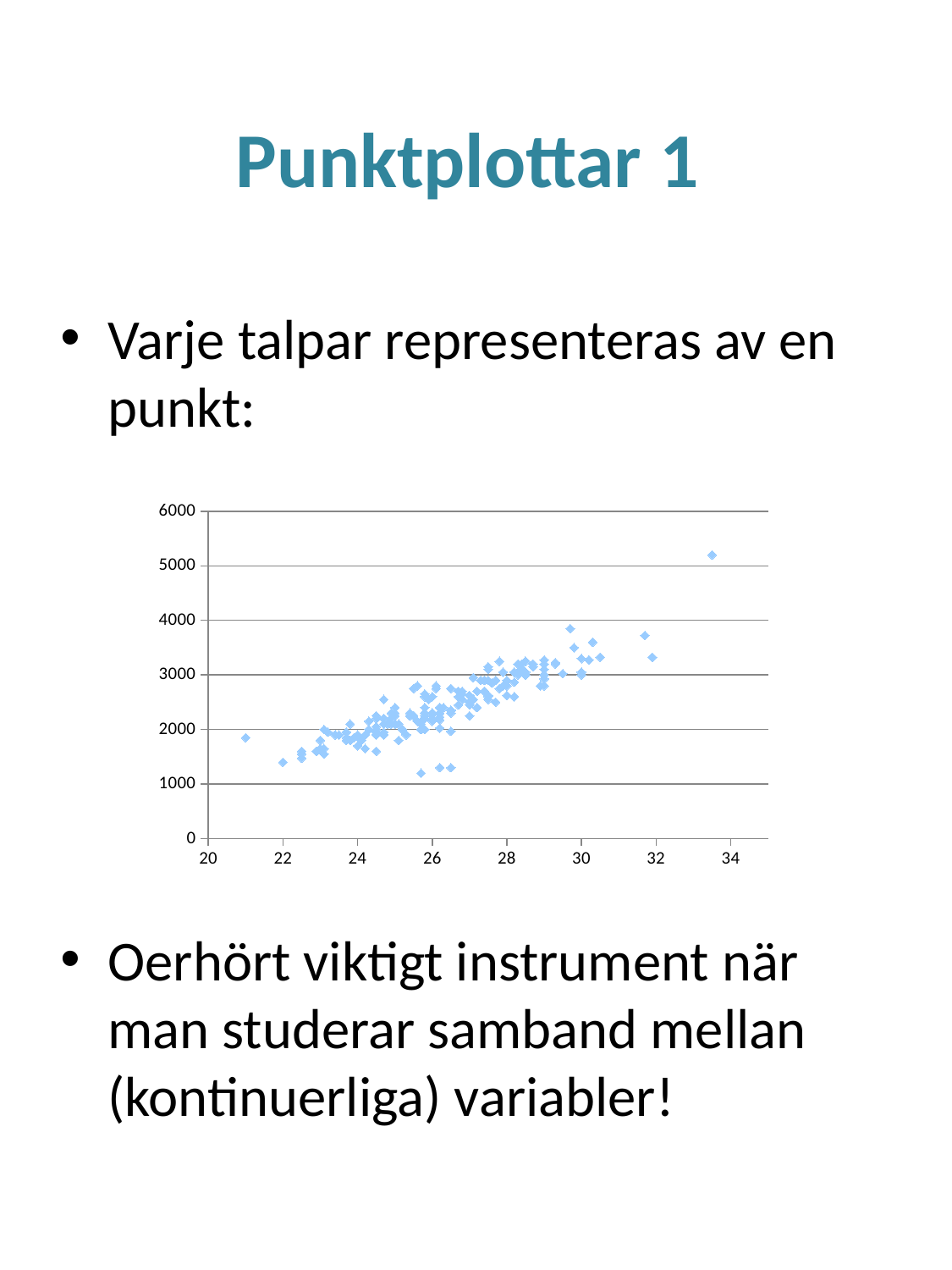
Do the y values generally rise or fall as the x values increase in the scatter plot? Rise Is the y value of the highest point in the scatter plot greater or less than 5000? greater What kind of chart is shown on the slide? Scatter plot Is the x value of the rightmost point in the scatter plot greater or less than 32? greater What is the lowest value shown on the x axis of the scatter plot? 20 Is the y value of the lowest point in the scatter plot greater or less than 1000? greater What is the highest value shown on the y axis of the scatter plot? 6000